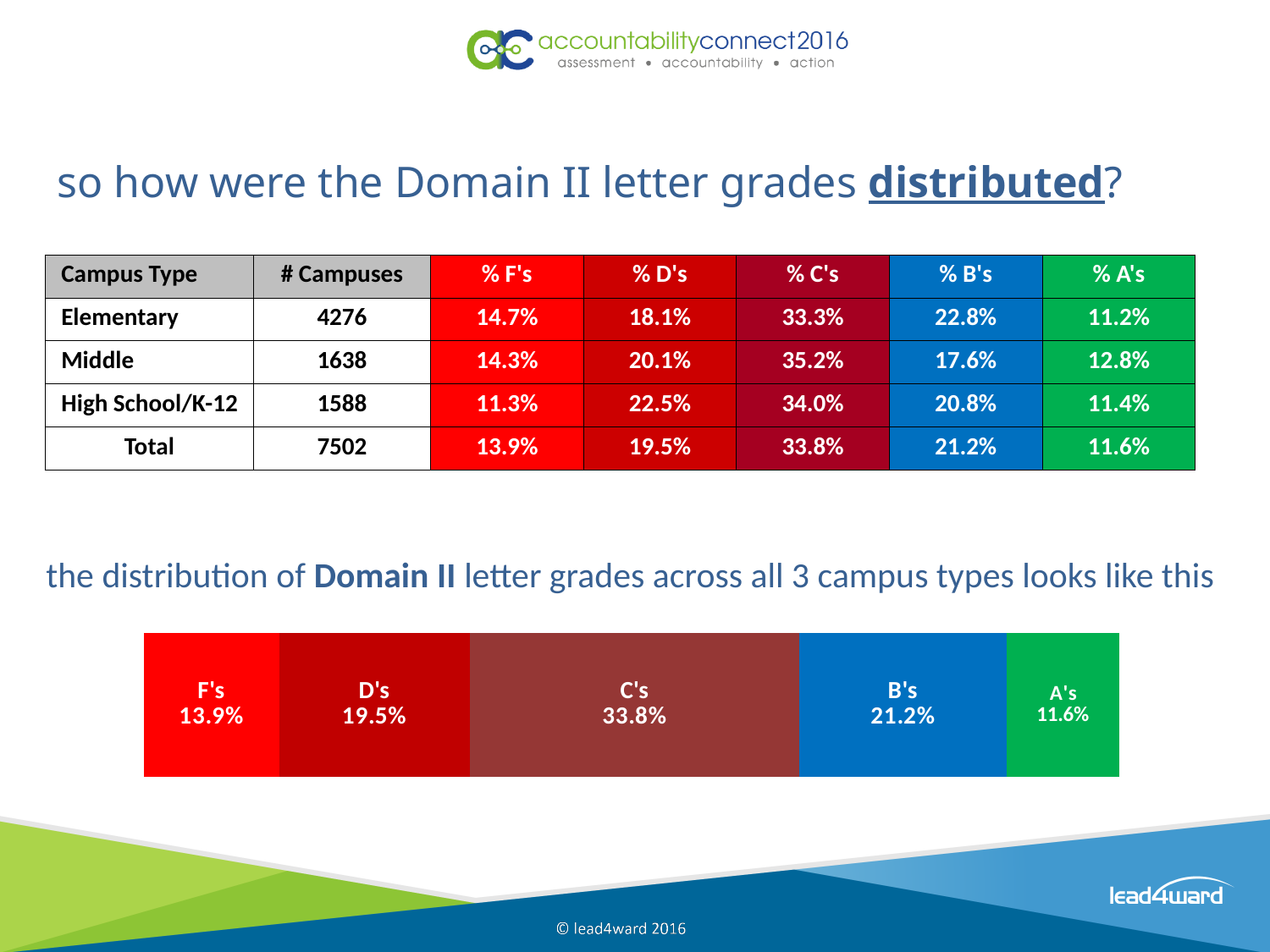
In the stacked bar chart at the bottom of the slide, what percentage is shown for A's? 11.6% In the stacked bar chart at the bottom of the slide, what percentage is shown for F's? 13.9% In the stacked bar chart at the bottom of the slide, what colour is the segment for A's? Green What kind of chart is shown at the bottom of the slide? Stacked bar chart In the stacked bar chart at the bottom of the slide, how many letter-grade segments are shown? 5 In the stacked bar chart at the bottom of the slide, which letter grade has the largest share? C's In the stacked bar chart at the bottom of the slide, what is the combined percentage for F's and D's? 33.4% In the stacked bar chart at the bottom of the slide, what is the difference between the percentage for C's and the percentage for B's? 12.6% In the stacked bar chart at the bottom of the slide, which letter grade has the smallest share? A's In the stacked bar chart at the bottom of the slide, which is larger, the percentage for D's or the percentage for B's? B's In the stacked bar chart at the bottom of the slide, what percentage is shown for C's? 33.8% In the stacked bar chart at the bottom of the slide, what is the total of all five segments? 100%